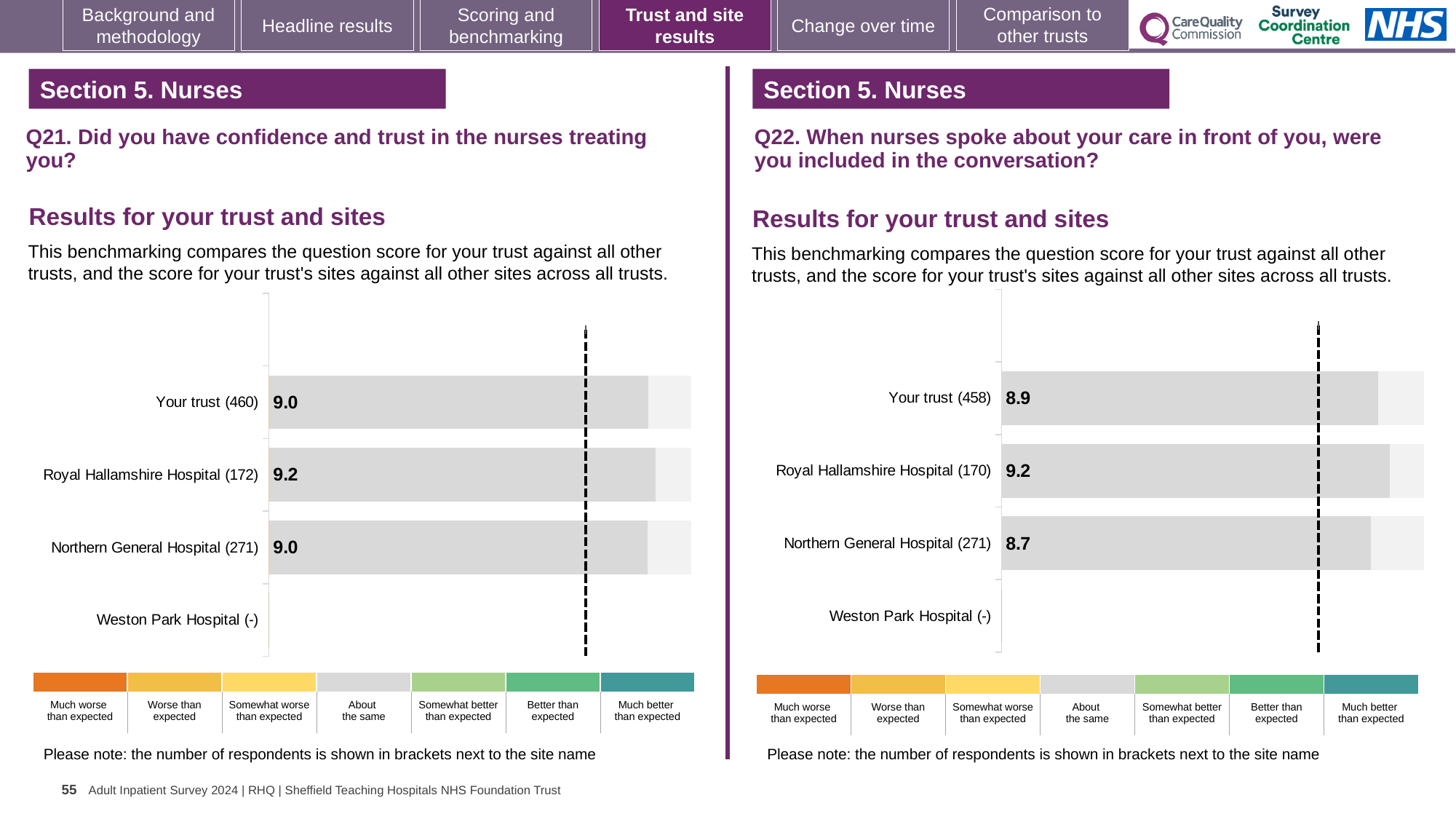
In the Q22 chart on the right, which site has the highest score? Royal Hallamshire Hospital In the Q21 chart on the left, what is the score for Your trust? 9.0 In the Q21 chart on the left, how many respondents are shown in brackets for Northern General Hospital? 271 How many site rows (including Your trust) are listed in the Q21 chart on the left? 4 In the Q22 chart on the right, what is the difference between the scores for Royal Hallamshire Hospital and Northern General Hospital? 0.5 In the Q22 chart on the right, which site with a score shown has the lowest score? Northern General Hospital In the Q21 chart on the left, what is the difference between the scores for Royal Hallamshire Hospital and Your trust? 0.2 What type of chart is used in the Q22 chart on the right? Bar chart In the Q22 chart on the right, what is the score for Your trust? 8.9 In the Q21 chart on the left, which has the higher score, Royal Hallamshire Hospital or Northern General Hospital? Royal Hallamshire Hospital In the Q21 chart on the left, what is the score for Royal Hallamshire Hospital? 9.2 In the Q22 chart on the right, what is the score for Northern General Hospital? 8.7